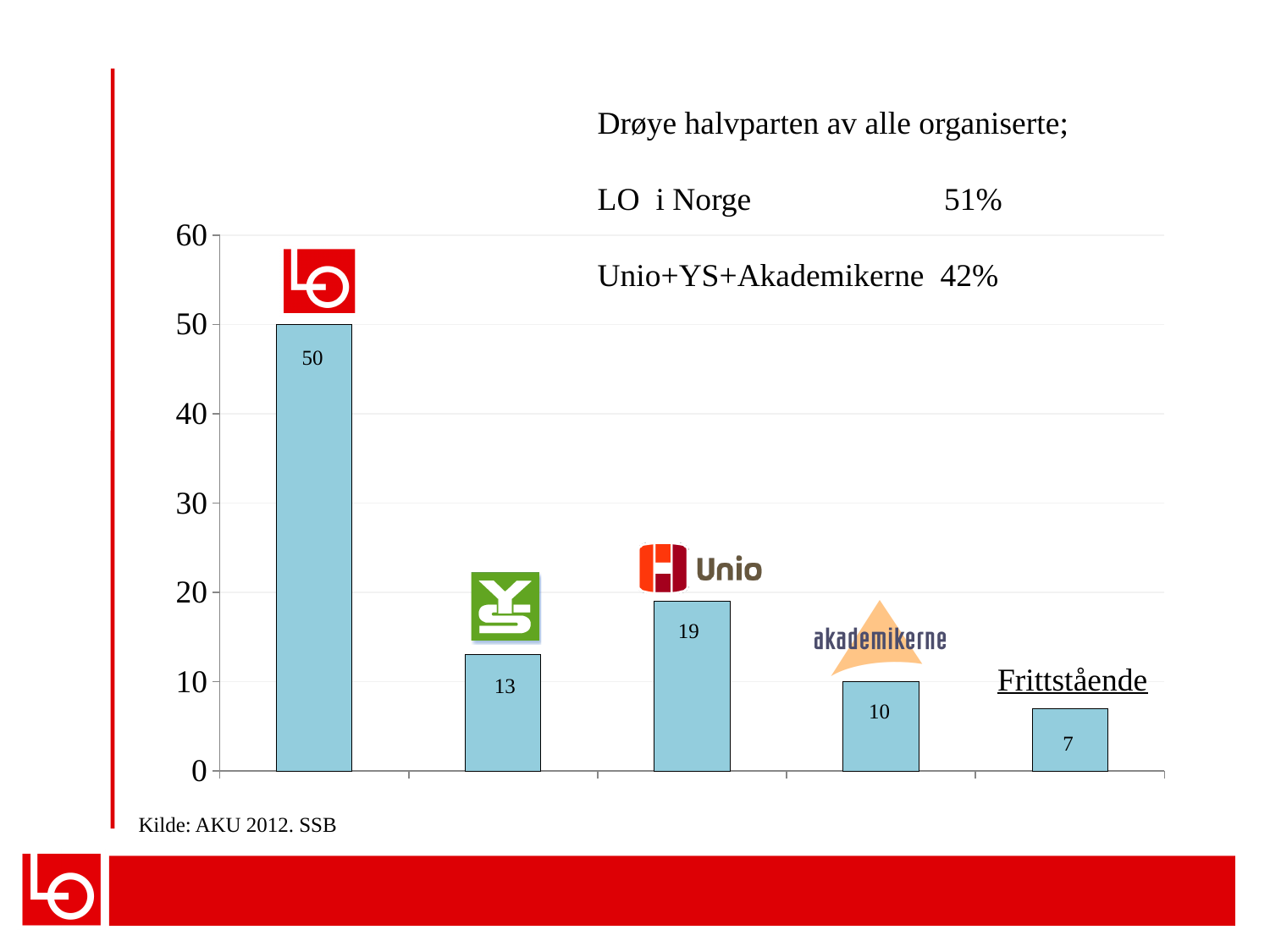
Which category has the highest bar? LO What is the source cited below the chart? Kilde: AKU 2012. SSB What is the value of the bar for Unio? 19 What is the difference between the YS bar and the Akademikerne bar? 3 What is the value of the bar for Frittstående? 7 Which is larger, the bar for YS or the bar for Unio? Unio What is the value of the bar for Akademikerne? 10 How many bars are shown in the chart? 5 What kind of chart is shown on the slide? Bar chart What is the value of the bar for LO? 50 Which category has the lowest bar? Frittstående What is the difference between the LO bar and the Unio bar? 31